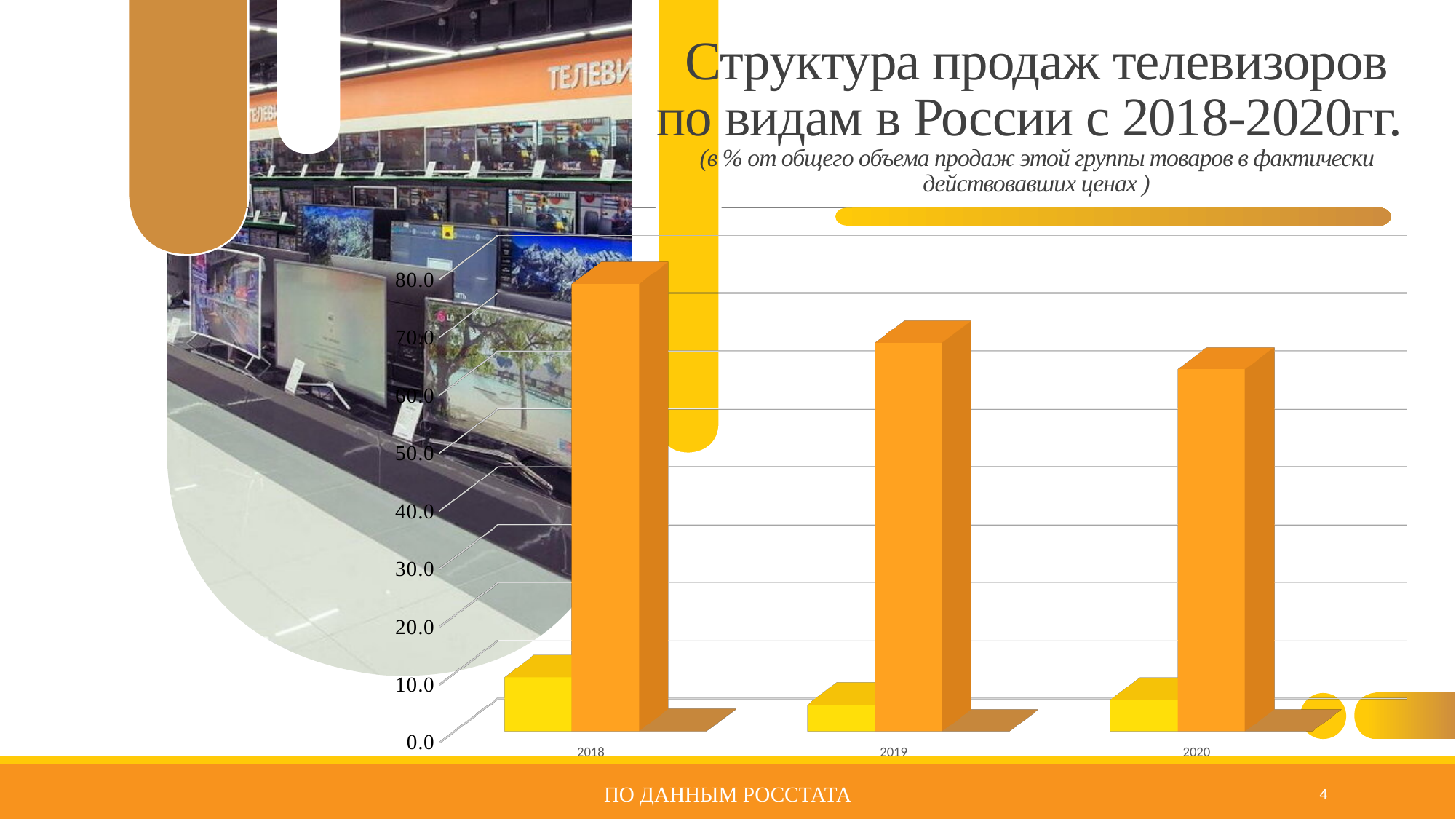
What kind of chart is shown on the slide? bar chart In 2018, which bar is taller, the orange one or the yellow one? the orange one Is the orange bar for 2019 taller or shorter than the orange bar for 2020? taller Is the yellow bar for 2018 greater or less than 20.0? less Is the orange bar for 2019 greater or less than 60.0? greater What is the highest value labelled on the y axis of the chart? 80.0 How many years are shown on the x axis of the chart? 3 Is the orange bar for 2020 greater or less than 70.0? less Which year has the shortest orange bar? 2020 Do the orange bars rise or fall from 2018 to 2020? fall Which year has the tallest orange bar? 2018